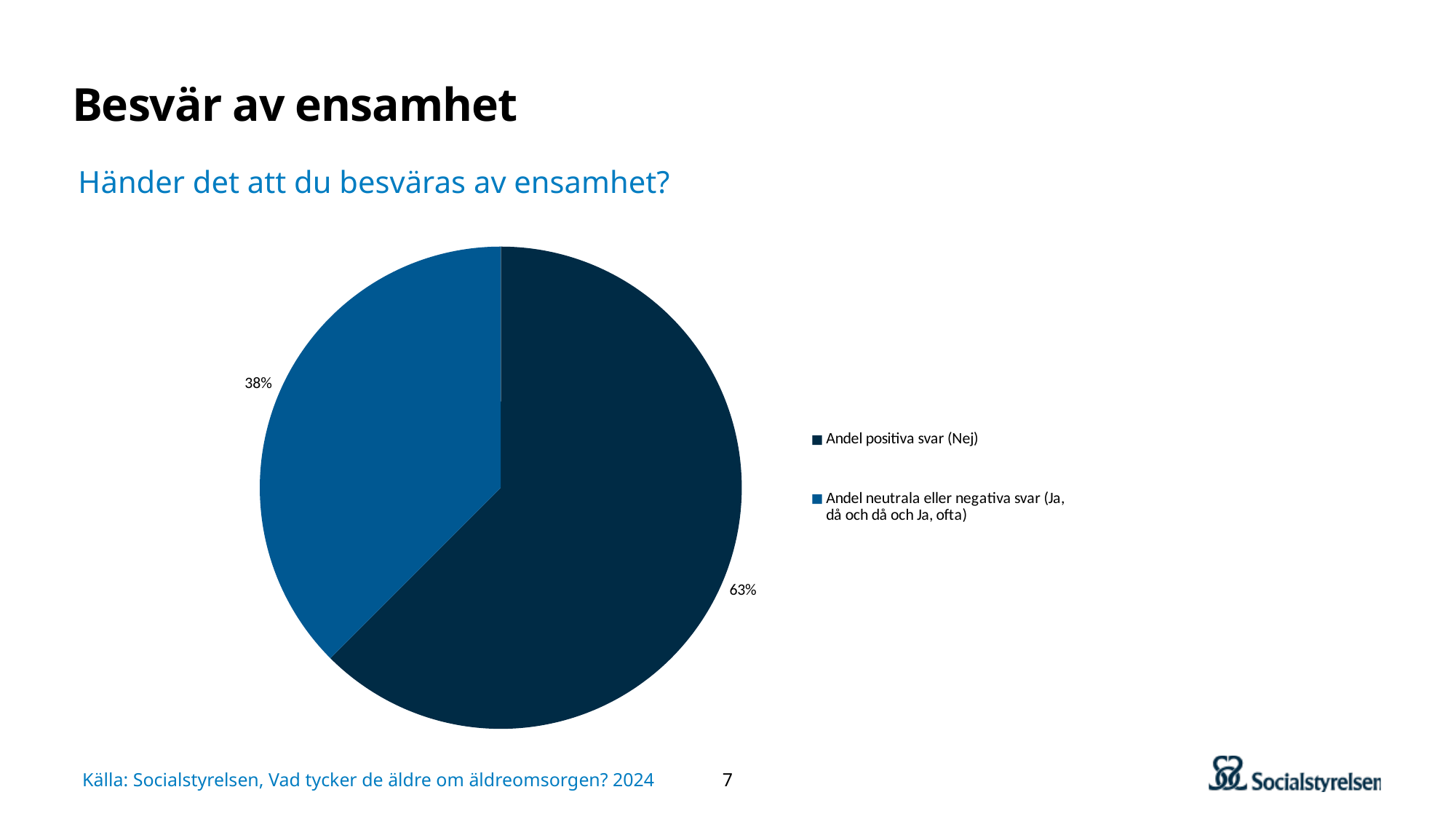
Which is larger: the share of positive answers (Nej) or the share of neutral or negative answers? Andel positiva svar (Nej) What question is shown as the chart's subtitle? Händer det att du besväras av ensamhet? Which slice of the pie is the largest? Andel positiva svar (Nej) Which slice of the pie is the smallest? Andel neutrala eller negativa svar (Ja, då och då och Ja, ofta) What share of the pie is 'Andel positiva svar (Nej)'? 63% What is the difference in percentage points between the 'Andel positiva svar (Nej)' slice and the 'Andel neutrala eller negativa svar' slice? 25 percentage points How many slices does the pie chart have? 2 What share of the pie is 'Andel neutrala eller negativa svar (Ja, då och då och Ja, ofta)'? 38% How many entries does the legend list? 2 What kind of chart is shown on the slide? pie chart Which colour represents 'Andel positiva svar (Nej)' in the pie chart? dark navy blue